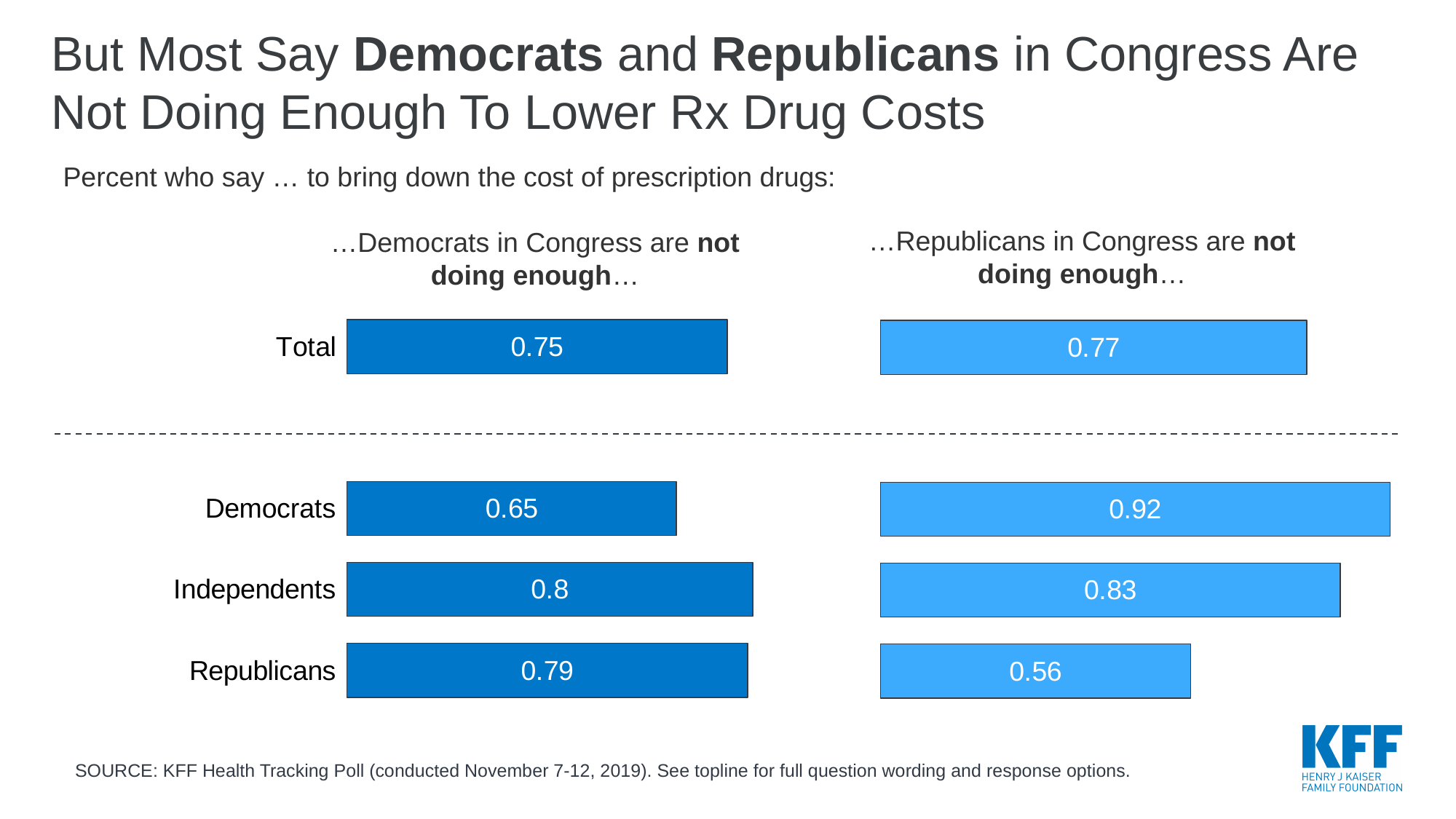
In the chart '…Republicans in Congress are not doing enough…', what is the value for Total? 0.77 In the chart '…Republicans in Congress are not doing enough…', which group has the lowest value? Republicans How many categories (bars) are shown in the chart '…Republicans in Congress are not doing enough…'? 4 What type of chart is used on this slide? Bar chart In the chart '…Democrats in Congress are not doing enough…', which group has the highest value? Independents In the chart '…Democrats in Congress are not doing enough…', what is the value for Total? 0.75 In the chart '…Republicans in Congress are not doing enough…', what is the difference between the values for Democrats and Republicans? 0.36 Which is larger: the Republicans value in the '…Democrats in Congress are not doing enough…' chart or the Republicans value in the '…Republicans in Congress are not doing enough…' chart? The '…Democrats in Congress are not doing enough…' chart (0.79) In the chart '…Democrats in Congress are not doing enough…', what is the value for Independents? 0.8 In the chart '…Democrats in Congress are not doing enough…', which group has the lowest value? Democrats In the chart '…Democrats in Congress are not doing enough…', what is the difference between the values for Independents and Democrats? 0.15 In the chart '…Republicans in Congress are not doing enough…', what is the value for Democrats? 0.92